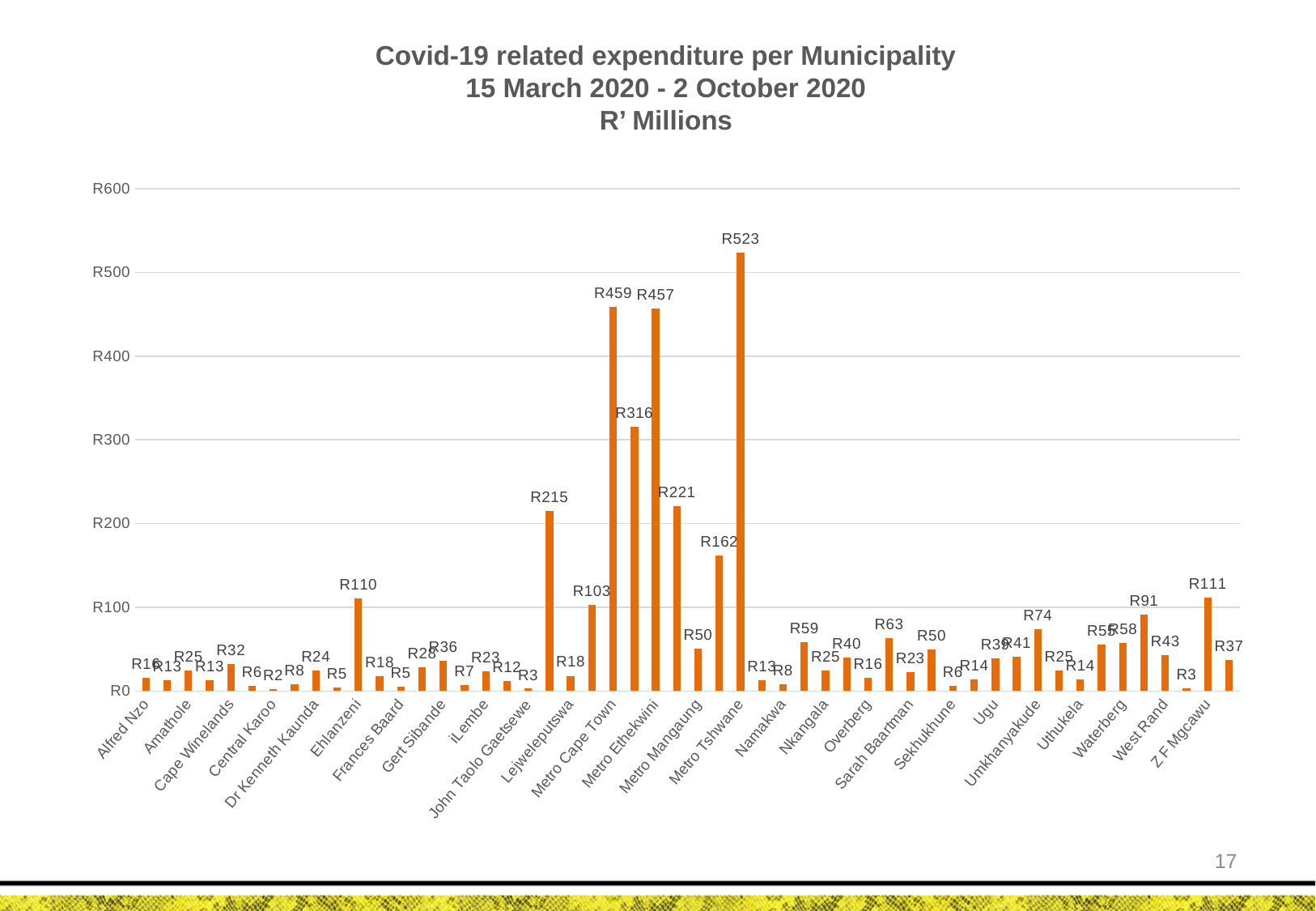
What is the Covid-19 related expenditure for Metro Cape Town? R459 What is the lowest value shown on the chart? R2 What is the Covid-19 related expenditure for Ehlanzeni? R110 Is the value for Ehlanzeni greater or less than R100? greater What is the Covid-19 related expenditure for Metro Ethekwini? R457 What is the difference between the expenditure for Metro Tshwane and Metro Cape Town? R64 What type of chart is shown on the slide? bar chart What is the highest value shown on the chart? R523 Which municipality has the highest Covid-19 related expenditure? Metro Tshwane What unit is stated in the chart title for the values? R' Millions What is the Covid-19 related expenditure for Alfred Nzo? R16 Which is larger, the expenditure for Metro Tshwane or Metro Ethekwini? Metro Tshwane